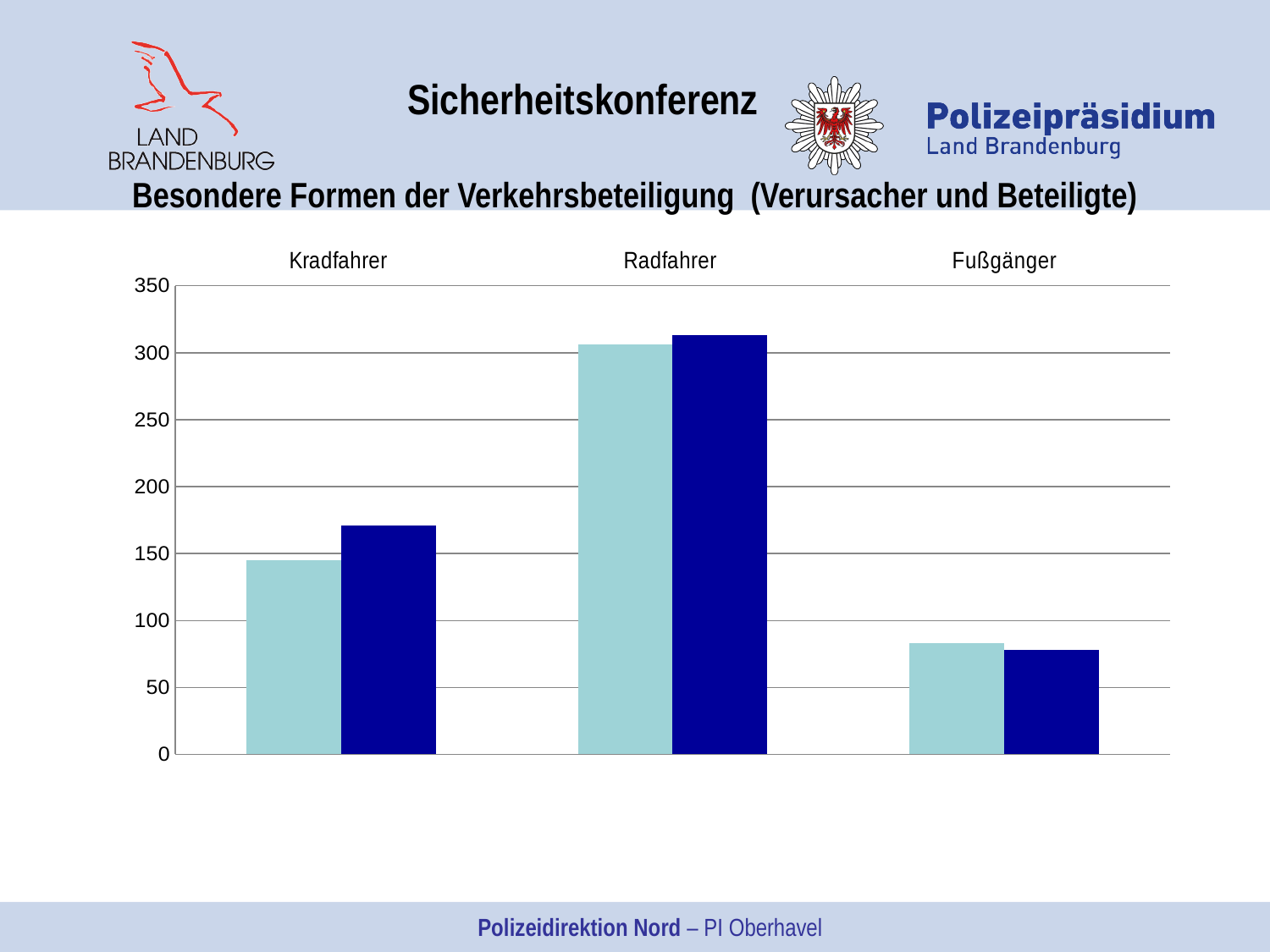
Which category has the tallest bars in the chart? Radfahrer What kind of chart is shown on the slide? bar chart What is the title of the chart on the slide? Besondere Formen der Verkehrsbeteiligung (Verursacher und Beteiligte) Is the value of the light blue bar for Radfahrer greater or less than 300? greater Which category has the shortest bars in the chart? Fußgänger Is the value of the light blue bar for Kradfahrer greater or less than 100? greater Is the value of the dark blue bar for Fußgänger greater or less than 100? less How many categories are shown on the x axis of the chart? 3 How many bars are plotted for each category in the chart? 2 For Kradfahrer, which bar is taller, the light blue bar or the dark blue bar? the dark blue bar